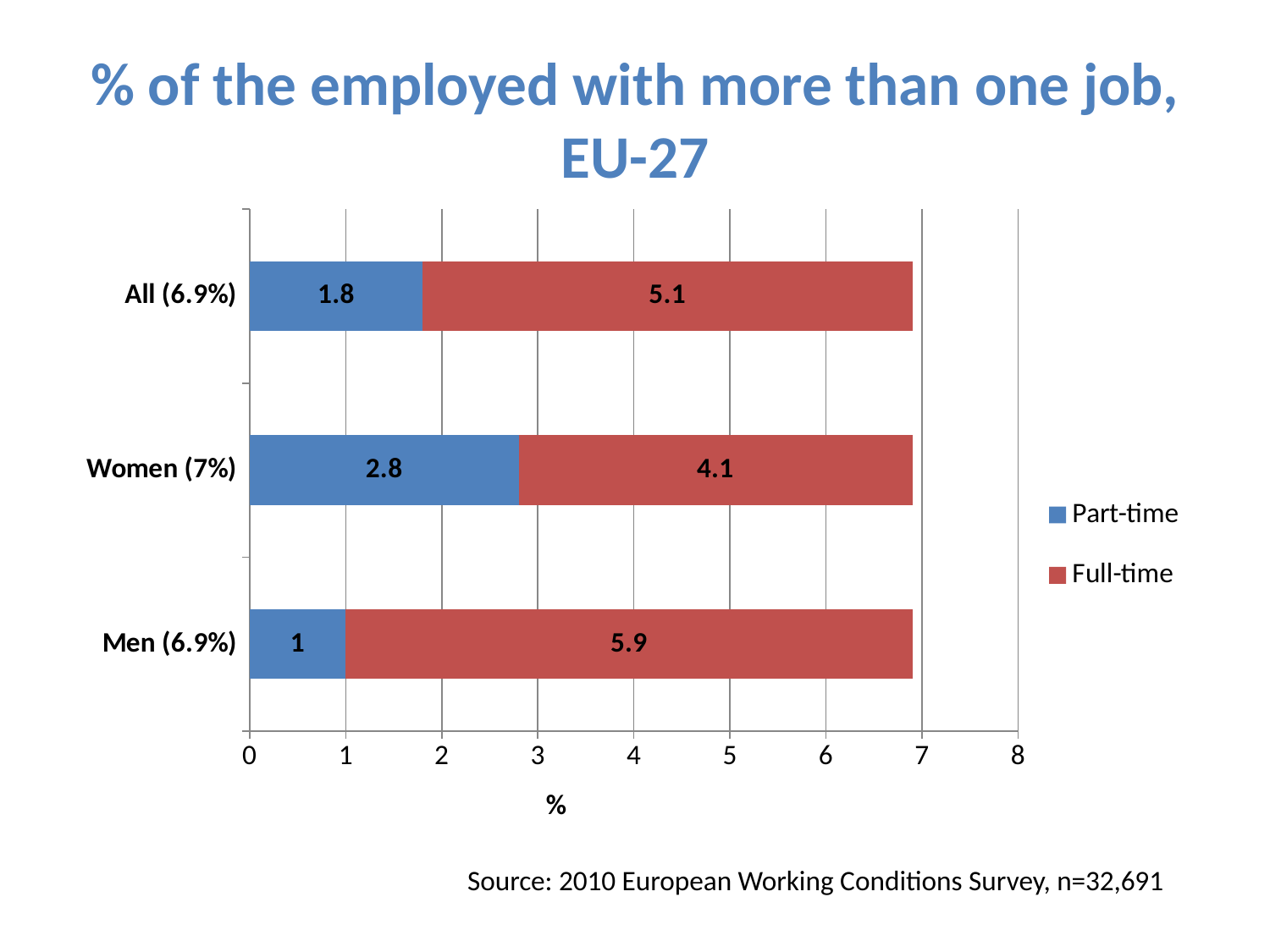
Which category has the lowest Part-time value? Men (6.9%) What is the difference between the Full-time values for Men (6.9%) and Women (7%)? 1.8 How many categories are shown on the chart? 3 What is the Full-time value for Men (6.9%)? 5.9 How many series does the legend list? 2 What kind of chart is shown on the slide? Stacked bar chart Which category has the highest Full-time value? Men (6.9%) What is the Part-time value for All (6.9%)? 1.8 What is the total of the stacked bar for Women (7%)? 6.9 What is the Part-time value for Women (7%)? 2.8 What is the title of the chart? % of the employed with more than one job, EU-27 Which is larger, the Part-time value for Women (7%) or the Part-time value for All (6.9%)? Women (7%)